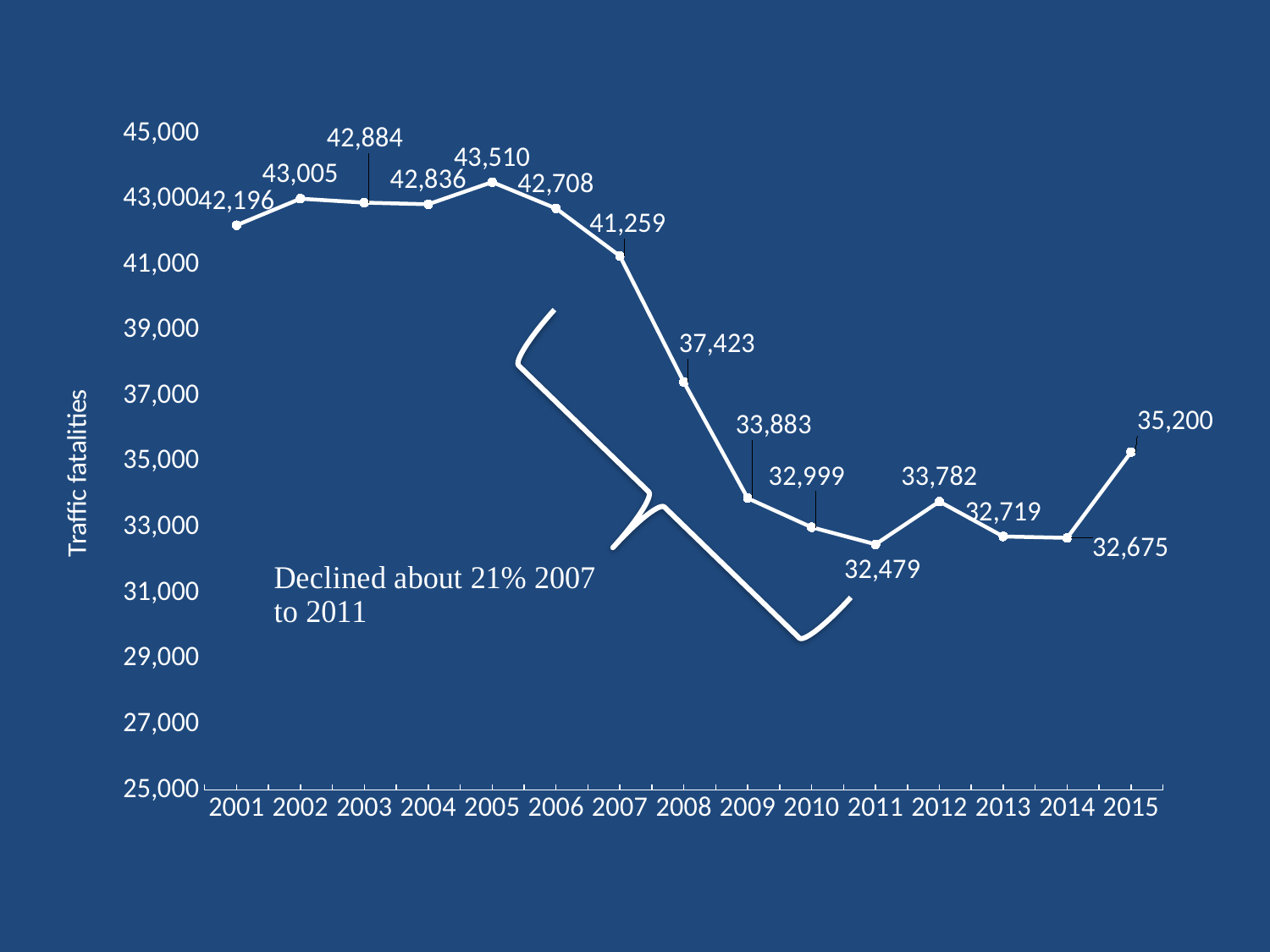
Which year has the highest value? 2005 What is the difference between the values for 2015 and 2014? 2,525 Which is larger, the value for 2002 or the value for 2003? 2002 What kind of chart is shown? Line chart What is the label on the y axis? Traffic fatalities What is the value for 2008? 37,423 Which year has the lowest value? 2011 How many years are plotted on the x axis? 15 What is the difference between the values for 2007 and 2011? 8,780 What is the value for 2011? 32,479 What is the value for 2015? 35,200 What is the value for 2005? 43,510